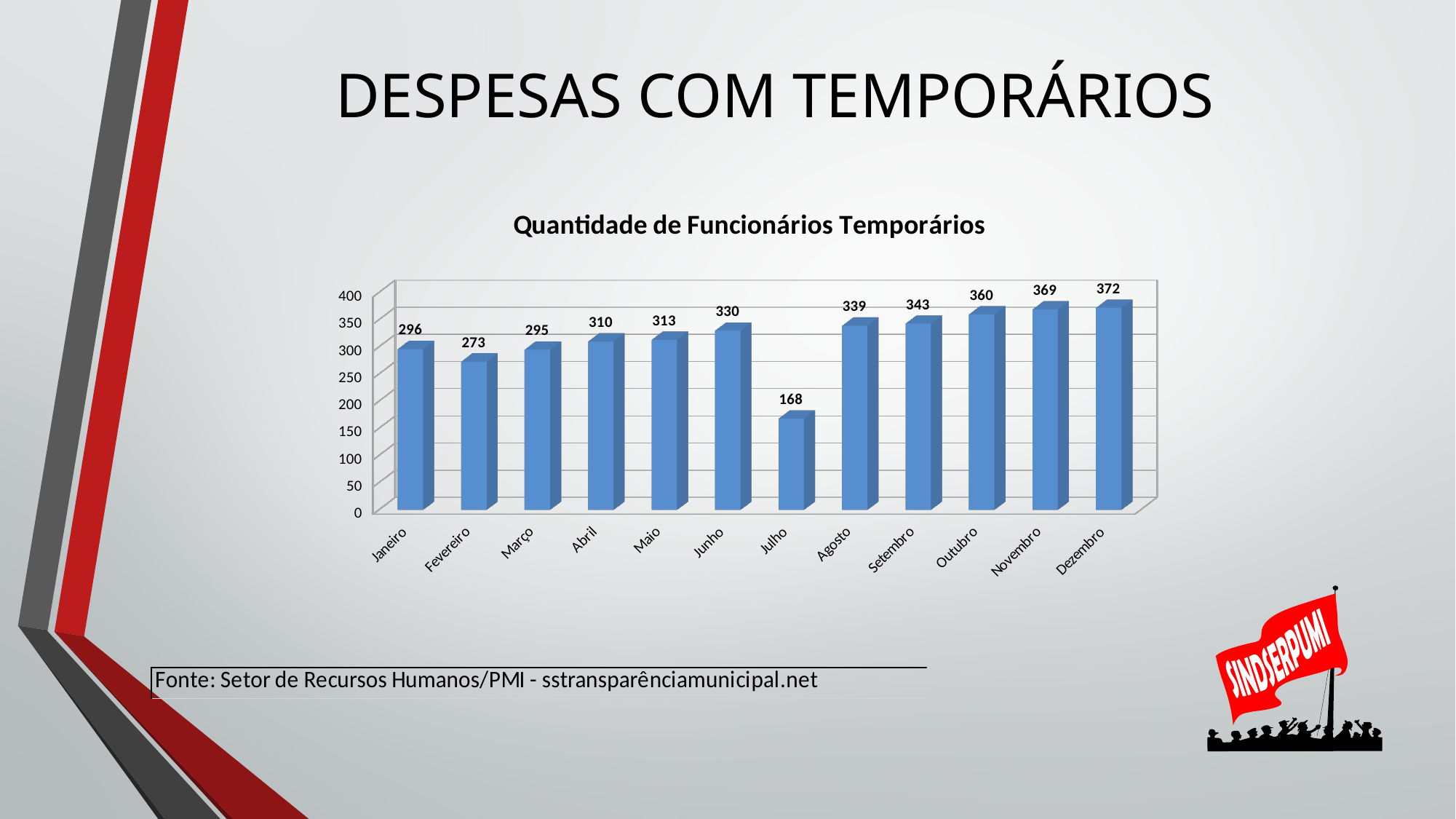
Which is larger, the value for Junho or the value for Agosto? Agosto Which month has the highest value? Dezembro What is the value for Julho? 168 What is the value for Dezembro? 372 What is the difference between the values for Dezembro and Julho? 204 How many months are shown on the x axis? 12 Which month has the lowest value? Julho What is the title of the chart? Quantidade de Funcionários Temporários Is the value for Julho greater or less than 200? less What kind of chart is shown on the slide? bar chart What is the difference between the values for Fevereiro and Janeiro? 23 What is the value for Janeiro? 296